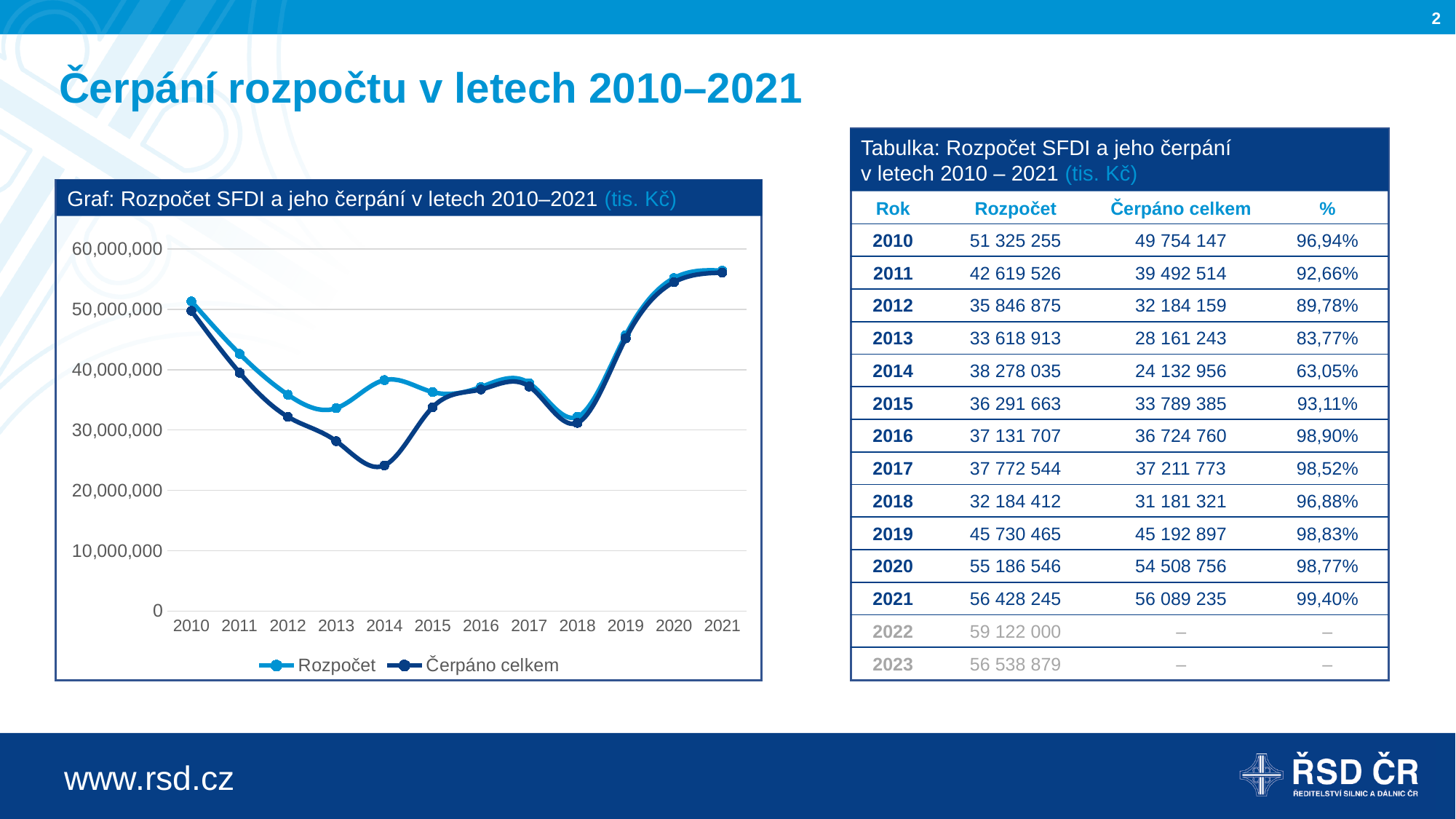
In which year is Čerpáno celkem at its lowest? 2014 What is the difference between Rozpočet and Čerpáno celkem in 2014 (tis. Kč)? 14 145 079 What is the Rozpočet value for 2015 (tis. Kč)? 36 291 663 What kind of chart is shown on the slide? line chart In which year is Rozpočet at its highest? 2021 How many series does the chart's legend list? 2 Does the Rozpočet line rise or fall from 2010 to 2013? fall In 2014, which series has the larger value, Rozpočet or Čerpáno celkem? Rozpočet How many years are plotted along the x axis of the chart? 12 Is the value for Rozpočet in 2021 greater or less than 50,000,000? greater What unit is given in the chart title? tis. Kč Is the value for Čerpáno celkem in 2014 greater or less than 30,000,000? less